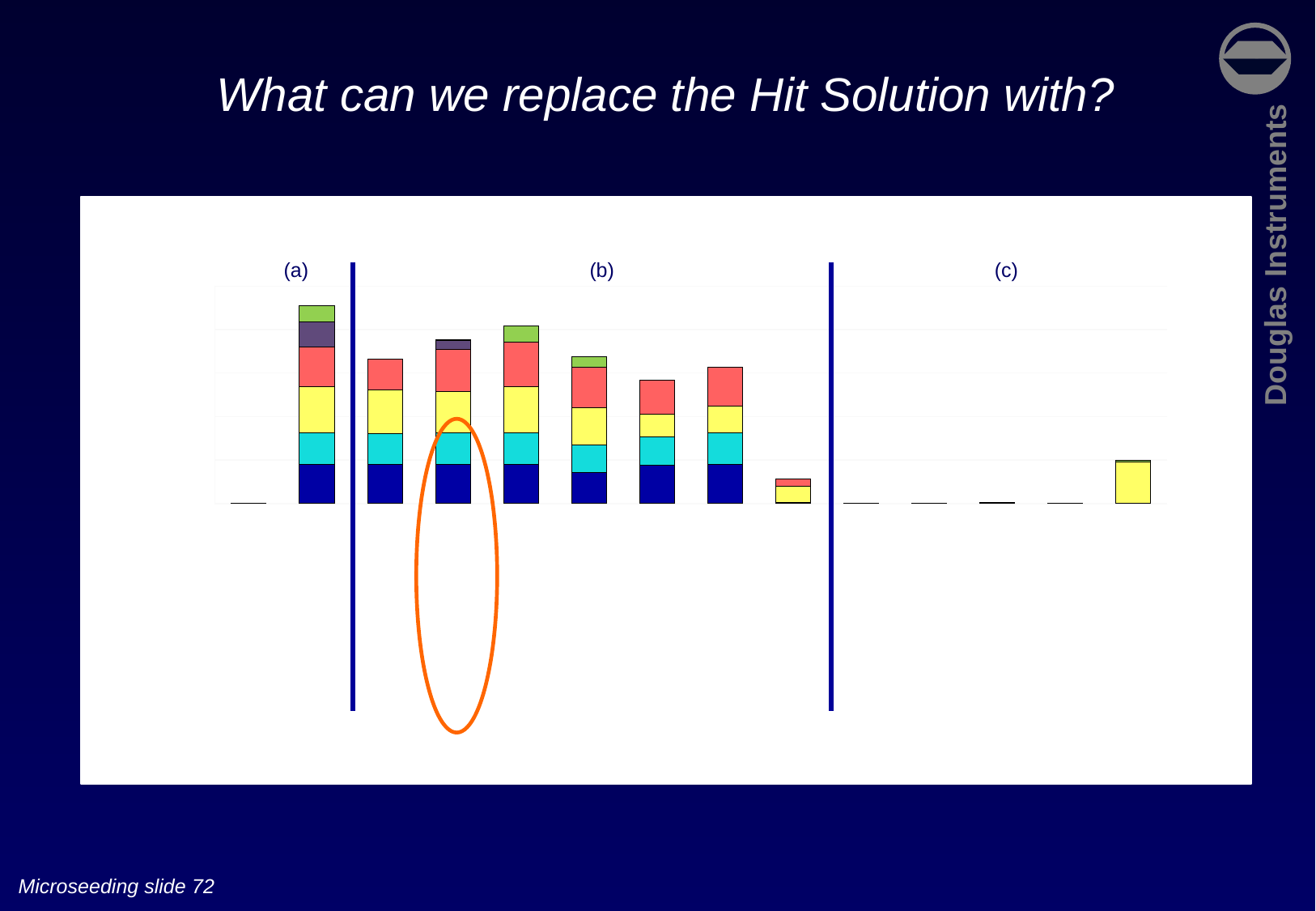
Which group has the fewest bars? (a) Which is taller: the tallest bar in group (a) or the tallest bar in group (b)? the tallest bar in group (a) Which group contains the most bars? (b) What are the labels of the three groups in the chart? (a), (b), (c) What kind of chart is shown on the slide? stacked bar chart How many bars are in group (b)? 7 Which group contains the tallest stacked bar in the chart? (a) How many coloured segments make up the tall stacked bar in group (a)? 6 Which bar is highlighted with an orange oval? the second bar in group (b) What colour is the only clearly visible bar in group (c)? yellow